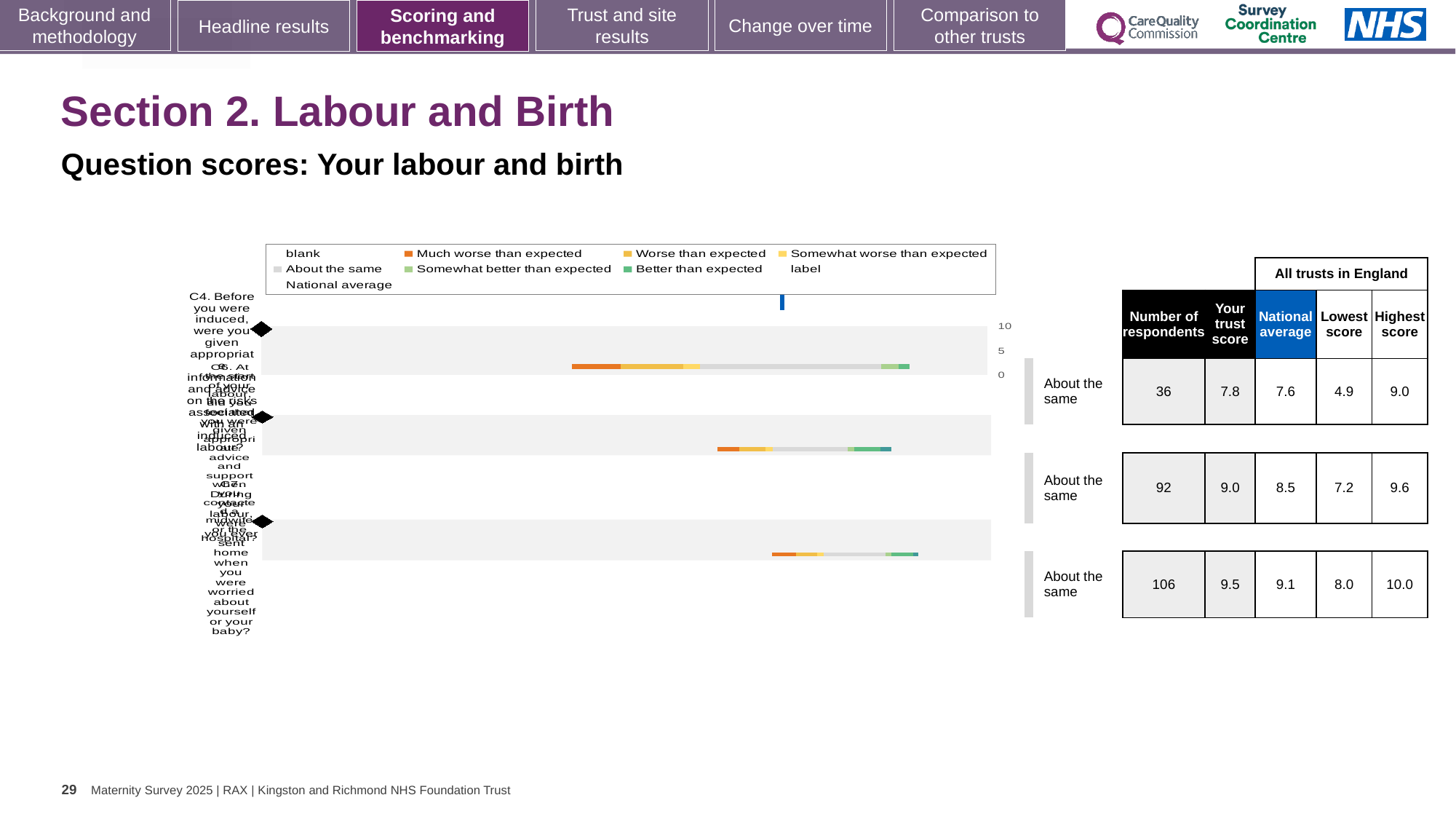
How many question rows (bars) are plotted in the chart? 3 What is the highest tick value shown on the chart's axis? 10 In the table beside the chart, what is the number of respondents for the top row? 36 What benchmark category label is shown to the right of the chart for the top row? About the same In the table beside the chart, what is the national average for the bottom row? 9.1 In the table beside the chart, is the trust score for the middle row larger or smaller than its national average? larger In the table beside the chart, which row has the highest trust score? the bottom row (9.5) How many entries does the chart legend list? 9 What kind of chart is shown on the slide? bar chart In the table beside the chart, what is the trust score for the middle row? 9.0 In the table beside the chart, what is the difference between the highest score and lowest score for the top row? 4.1 In the table beside the chart, what is the lowest score for the bottom row? 8.0